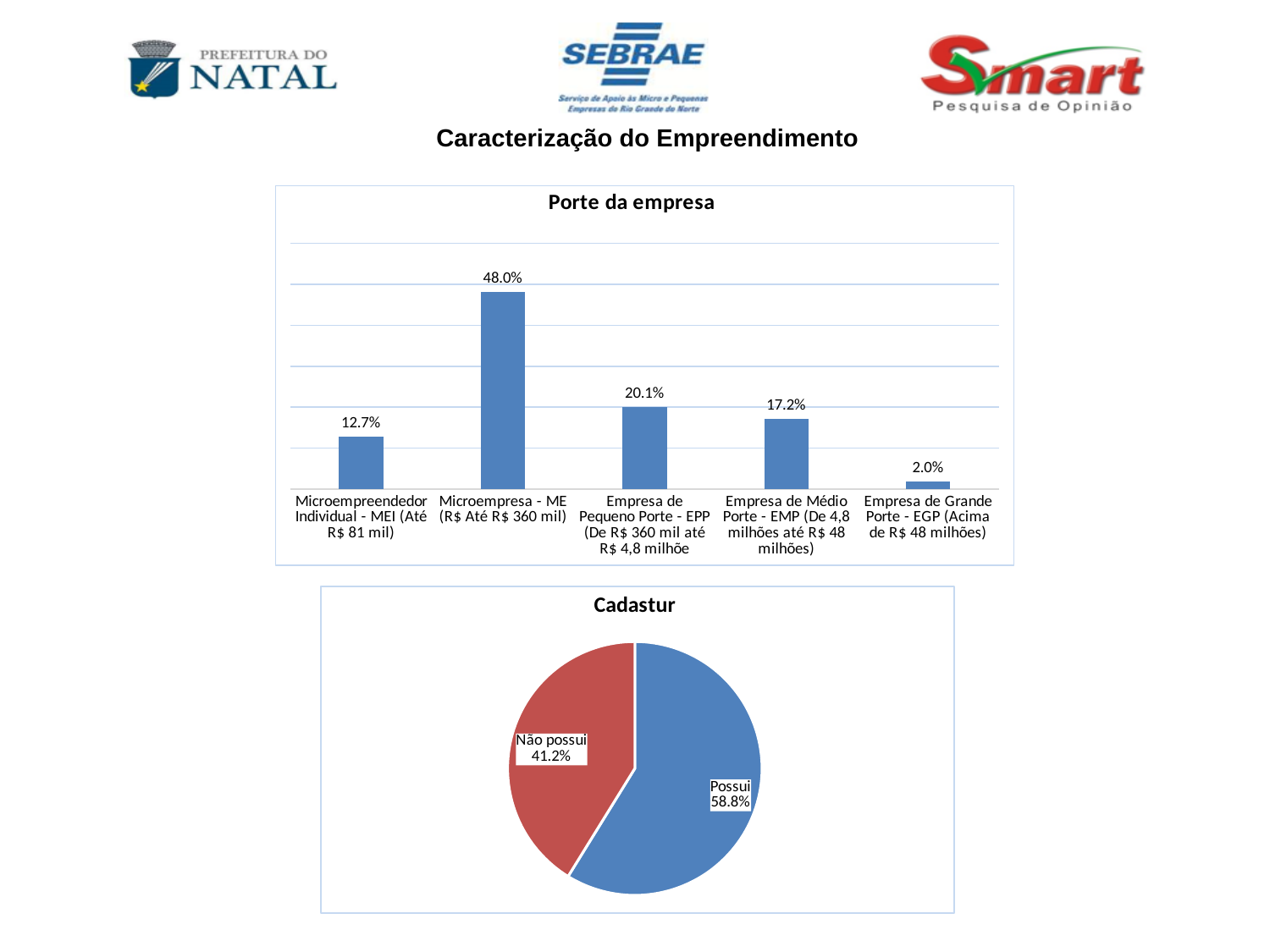
In the 'Porte da empresa' chart, what is the value for Microempresa - ME? 48.0% What kind of chart is 'Porte da empresa'? Bar chart In the 'Porte da empresa' chart, which is larger: Empresa de Pequeno Porte - EPP or Empresa de Médio Porte - EMP? Empresa de Pequeno Porte - EPP In the 'Cadastur' chart, what is the value for 'Não possui'? 41.2% In the 'Porte da empresa' chart, which category has the highest value? Microempresa - ME In the 'Porte da empresa' chart, which category has the lowest value? Empresa de Grande Porte - EGP In the 'Porte da empresa' chart, what is the value for Empresa de Médio Porte - EMP? 17.2% In the 'Cadastur' chart, what share does 'Possui' have? 58.8% What kind of chart is 'Cadastur'? Pie chart How many categories are shown in the 'Porte da empresa' chart? 5 In the 'Cadastur' chart, what is the difference between 'Possui' and 'Não possui'? 17.6% In the 'Porte da empresa' chart, what is the difference between Microempresa - ME and Microempreendedor Individual - MEI? 35.3%